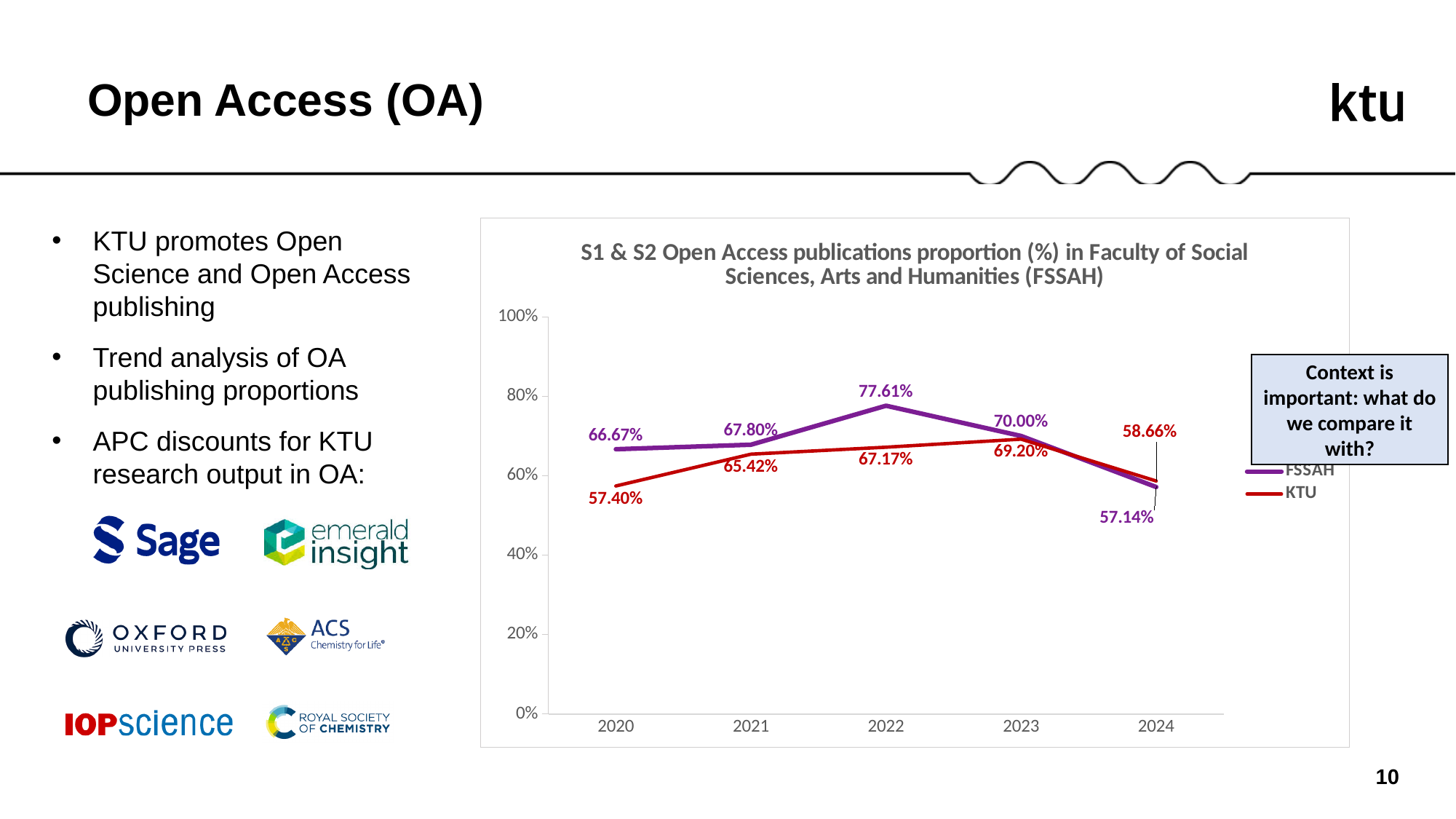
What is the FSSAH value for 2024? 57.14% In which year is the KTU value lowest? 2020 What is the difference between the FSSAH and KTU values in 2020? 9.27% In which year is the FSSAH value highest? 2022 How many years are plotted on the x axis? 5 How many series does the legend list? 2 Does the KTU series rise or fall from 2020 to 2023? rise What is the FSSAH value for 2022? 77.61% What type of chart is shown on the slide? line chart What is the KTU value for 2020? 57.40% Which series has the larger value in 2022, FSSAH or KTU? FSSAH Which colour is used for the FSSAH series? purple